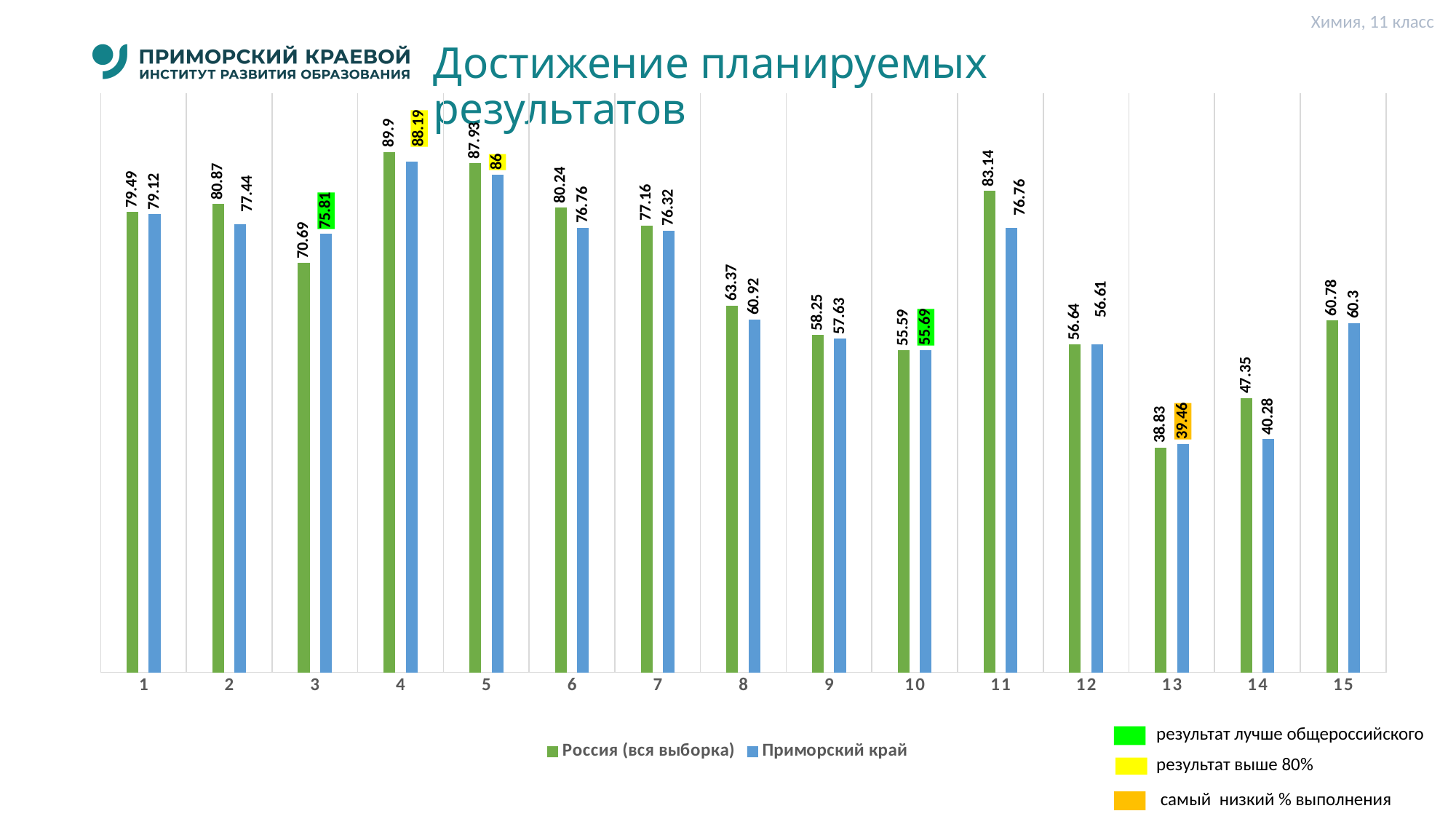
How many series does the legend list? 2 Which category has the highest value for Приморский край? 4 What is the difference between Россия (вся выборка) and Приморский край at category 11? 6.38 What kind of chart is shown on the slide? Bar chart How many categories are shown on the x axis? 15 What is the difference between Приморский край and Россия (вся выборка) at category 3? 5.12 What is the value for Приморский край at category 13? 39.46 At category 3, which series has the larger value: Россия (вся выборка) or Приморский край? Приморский край At category 14, which series has the larger value: Россия (вся выборка) or Приморский край? Россия (вся выборка) What is the value for Приморский край at category 4? 88.19 What is the value for Россия (вся выборка) at category 11? 83.14 Which category has the lowest value for Россия (вся выборка)? 13